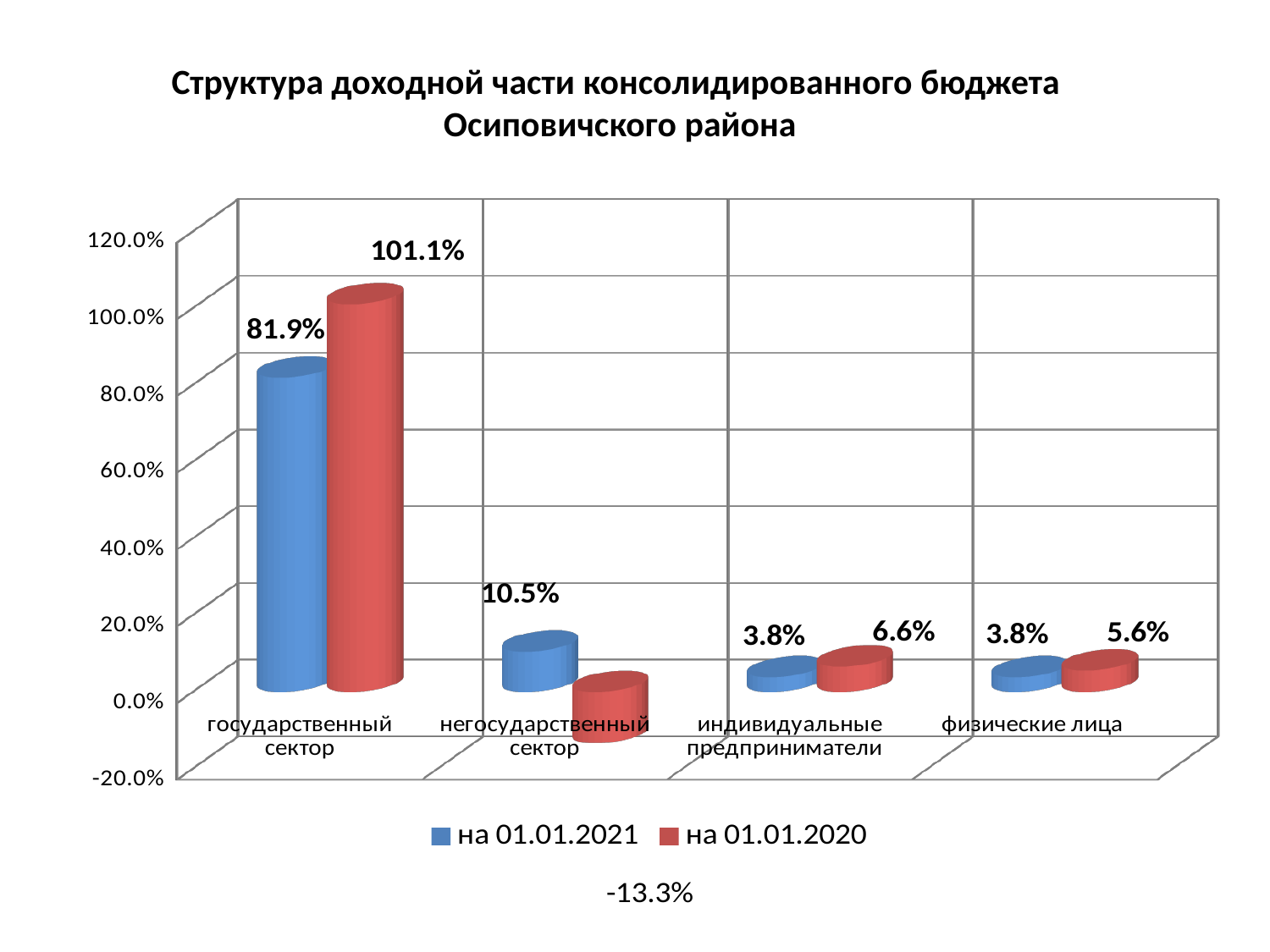
How many categories are shown on the x axis? 4 Which category has the lowest value in the series на 01.01.2020? негосударственный сектор What is the value for физические лица in the series на 01.01.2020? 5.6% For индивидуальные предприниматели, which series has the larger value: на 01.01.2021 or на 01.01.2020? на 01.01.2020 What is the value for индивидуальные предприниматели in the series на 01.01.2020? 6.6% What is the difference between the на 01.01.2020 and на 01.01.2021 values for государственный сектор? 19.2% Which category has the highest value in the series на 01.01.2021? государственный сектор What type of chart is shown on the slide? bar chart How many series does the legend list? 2 What is the value for негосударственный сектор in the series на 01.01.2021? 10.5% What is the value for государственный сектор in the series на 01.01.2020? 101.1% What is the value for государственный сектор in the series на 01.01.2021? 81.9%